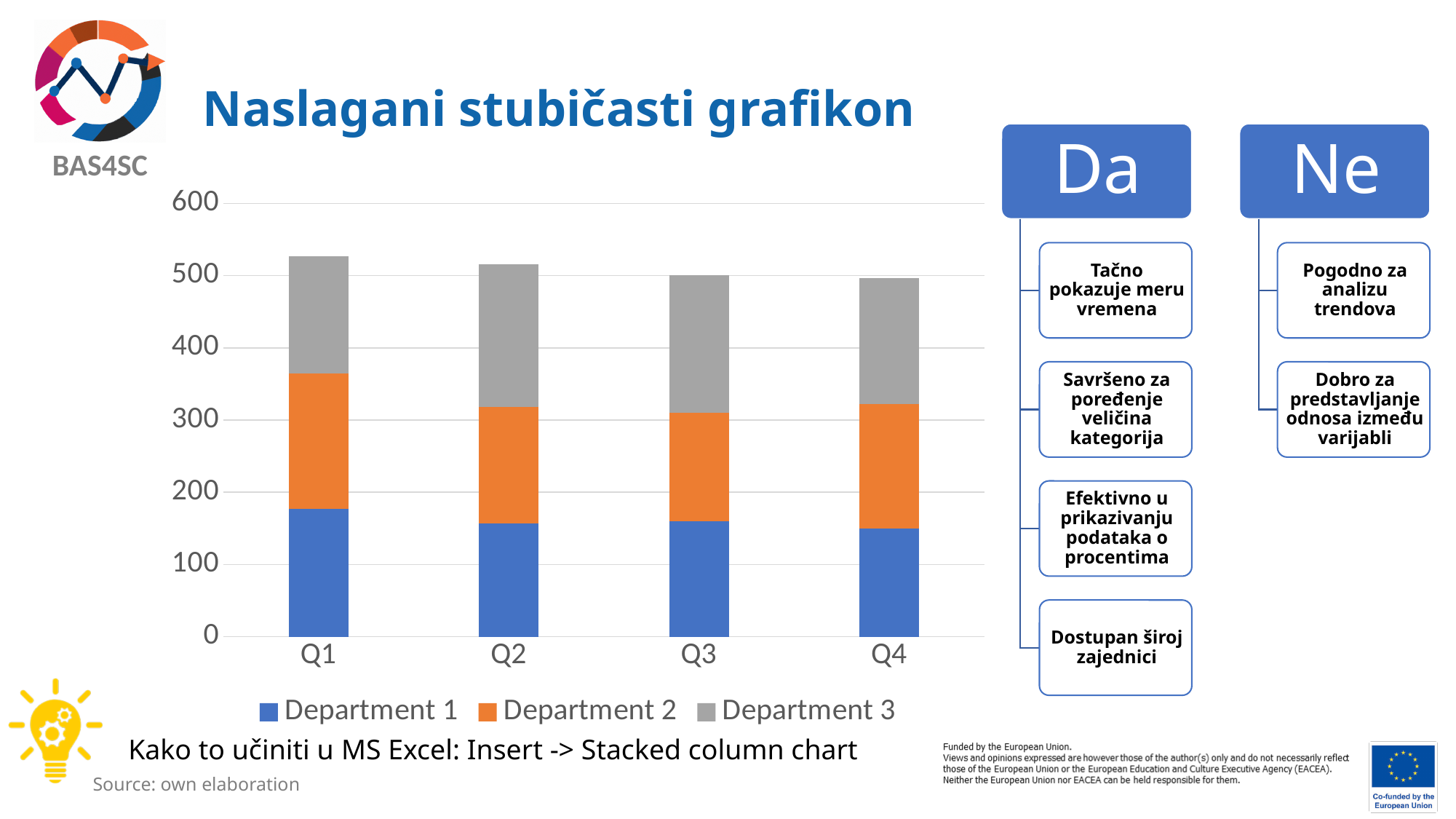
Is the value for Department 1 in Q1 greater or less than 200? less Is the total stacked value for Q1 greater or less than 600? less How many categories are shown on the x axis of the chart? 4 What is the title of the slide containing the chart? Naslagani stubičasti grafikon Which is larger: the Department 1 value in Q1 or the Department 1 value in Q4? Q1 Which colour represents Department 3 in the chart's legend? grey How many series does the chart's legend list? 3 What kind of chart is shown on the slide? stacked bar chart Is the total stacked value for Q1 greater or less than 500? greater Which quarter has the tallest stacked bar in total? Q1 Do the total stacked values rise or fall from Q1 to Q4? fall